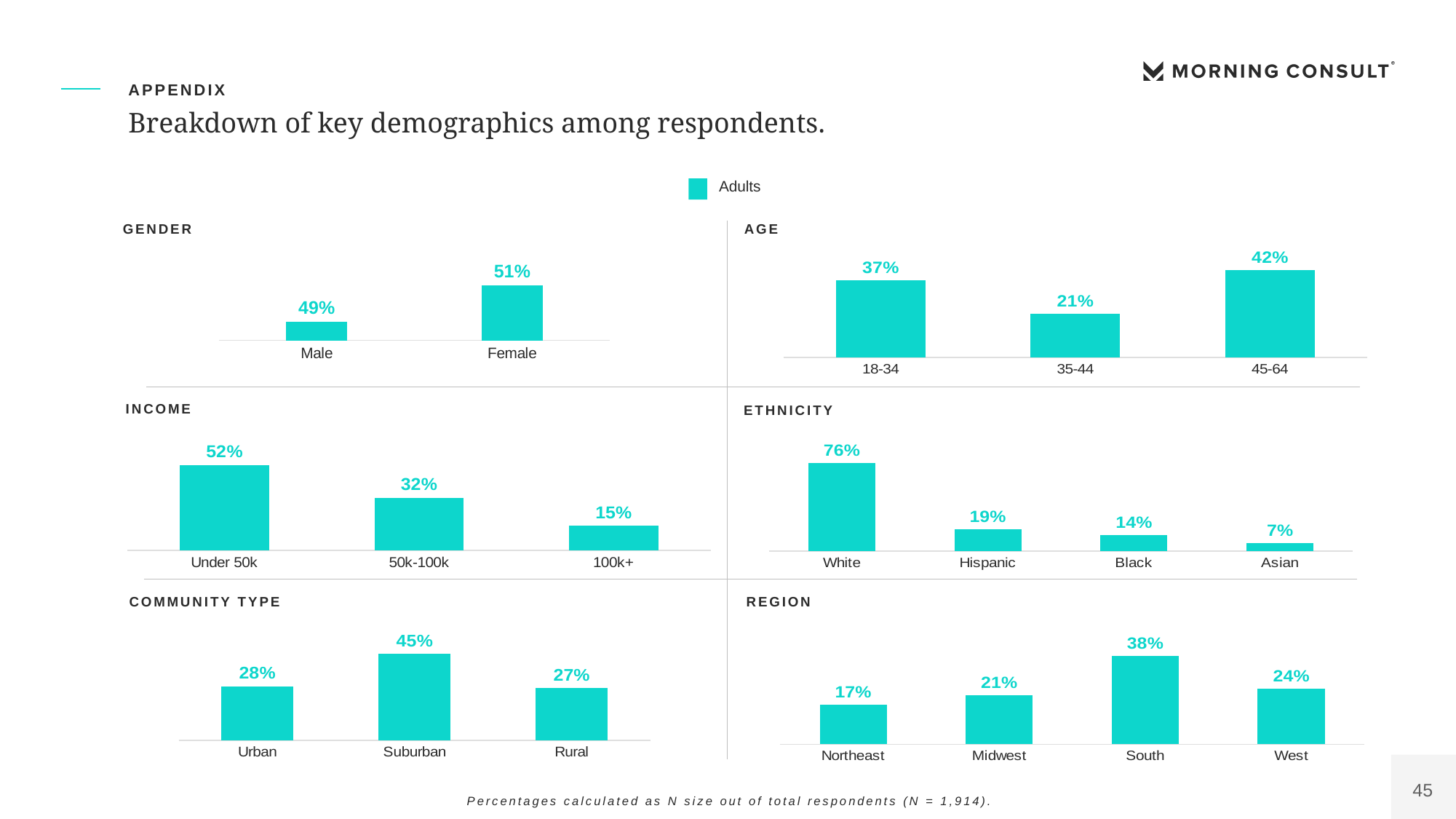
In the GENDER chart, what is the value for Female? 51% In the REGION chart, do the values rise or fall from Northeast to South? rise How many series does the legend list? 1 In the AGE chart, what is the value for 35-44? 21% In the COMMUNITY TYPE chart, which is larger, the value for Urban or the value for Rural? Urban In the REGION chart, how many regions are shown? 4 In the ETHNICITY chart, which category has the lowest value? Asian In the AGE chart, which age group has the highest value? 45-64 In the ETHNICITY chart, what is the value for Hispanic? 19% In the REGION chart, what is the difference between the values for South and Northeast? 21% What kind of chart is the INCOME chart? bar chart In the INCOME chart, what is the difference between the values for Under 50k and 100k+? 37%